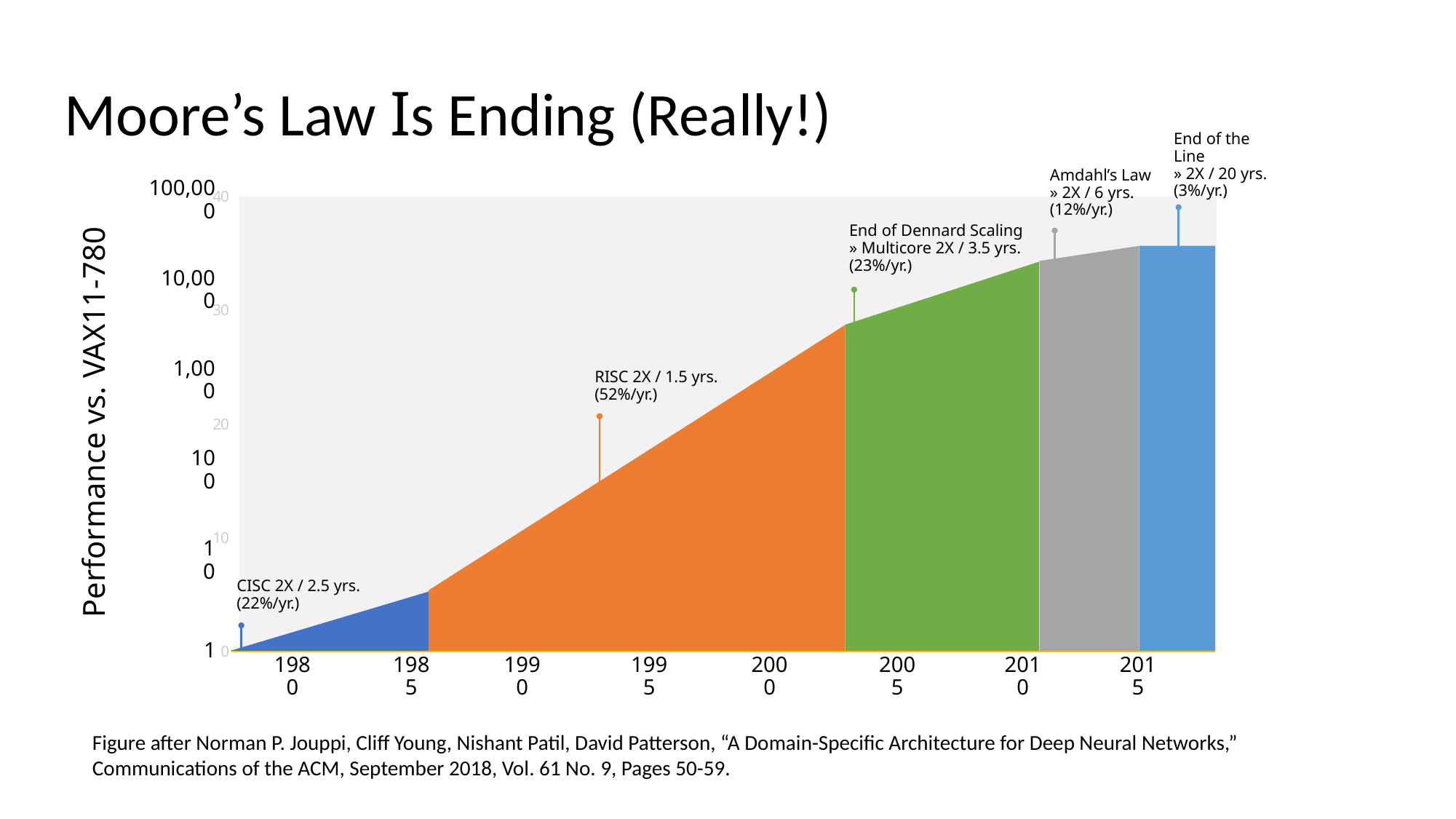
What annual growth rate is given for the 'End of the Line' era? 3%/yr. What is the label on the y axis? Performance vs. VAX11-780 Is the performance value around 2015 greater or less than 10,000? greater What kind of chart is shown on the slide? area chart What annual growth rate is given for the CISC era? 22%/yr. Which era has the lowest annual growth rate annotated on the chart? End of the Line What annual growth rate is given for the RISC era? 52%/yr. What doubling period is given for the Amdahl's Law era? 2X / 6 yrs. Which era has the highest annual growth rate annotated on the chart? RISC How many coloured eras (segments) are shown in the chart? 5 Is the performance value around 1985 greater or less than 10? less Does performance rise or fall over time along the x axis? rise